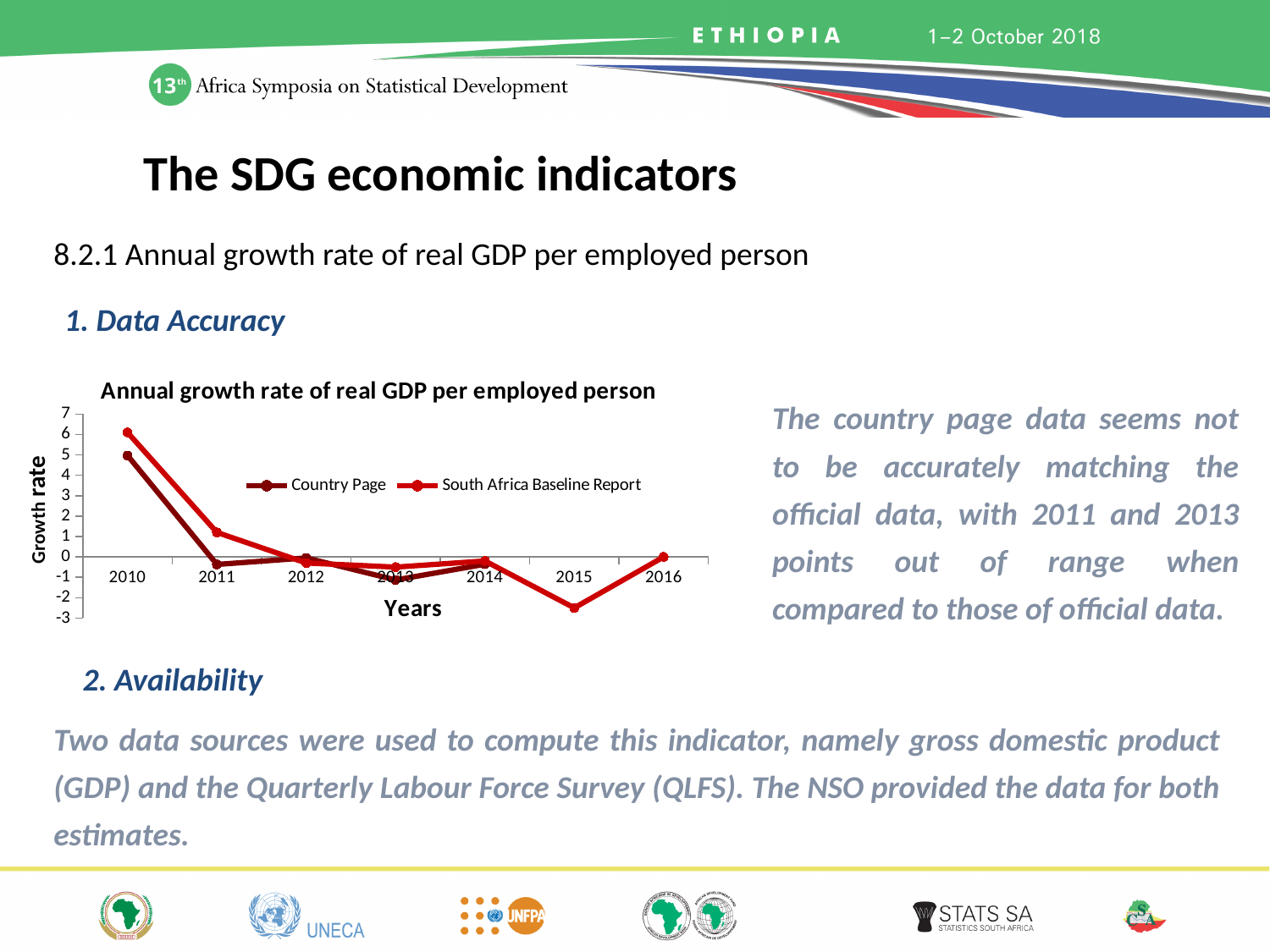
Is the South Africa Baseline Report value for 2015 greater or less than -2? less How many years are shown on the x axis of the chart? 7 What is the title of the y axis of the chart? Growth rate Does the South Africa Baseline Report series rise or fall from 2010 to 2011? Fall What are the two series named in the chart legend? Country Page and South Africa Baseline Report Is the South Africa Baseline Report value for 2010 greater or less than 5? greater In which year is the South Africa Baseline Report value lowest? 2015 What kind of chart is shown on the slide? Line chart In which year is the Country Page value highest? 2010 How many series does the legend of the chart list? 2 In 2011, which series has the larger value, Country Page or South Africa Baseline Report? South Africa Baseline Report In which year is the South Africa Baseline Report value highest? 2010